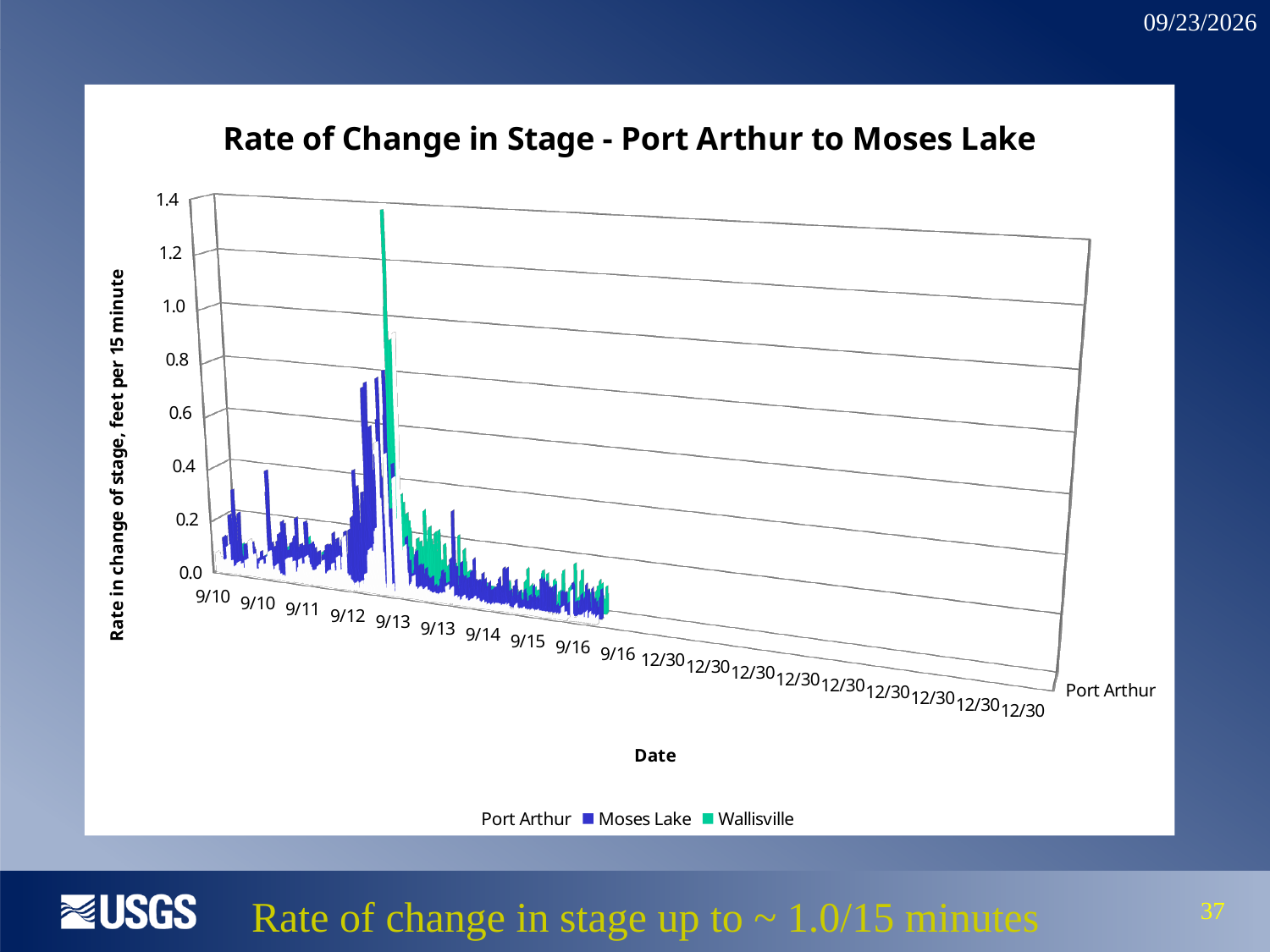
Which series reaches the highest rate of change in stage on the chart? Wallisville How many series does the chart legend list? 3 Is the peak value for Wallisville greater or less than 1.2? greater Which series has the larger peak value, Wallisville or Moses Lake? Wallisville What is the title of the chart? Rate of Change in Stage - Port Arthur to Moses Lake Is the peak value for Moses Lake greater or less than 1.0? less What kind of chart is shown on the slide? area chart What is the label of the vertical axis? Rate in change of stage, feet per 15 minute After the peak around 9/13, do the plotted values generally rise or fall toward 9/16? fall